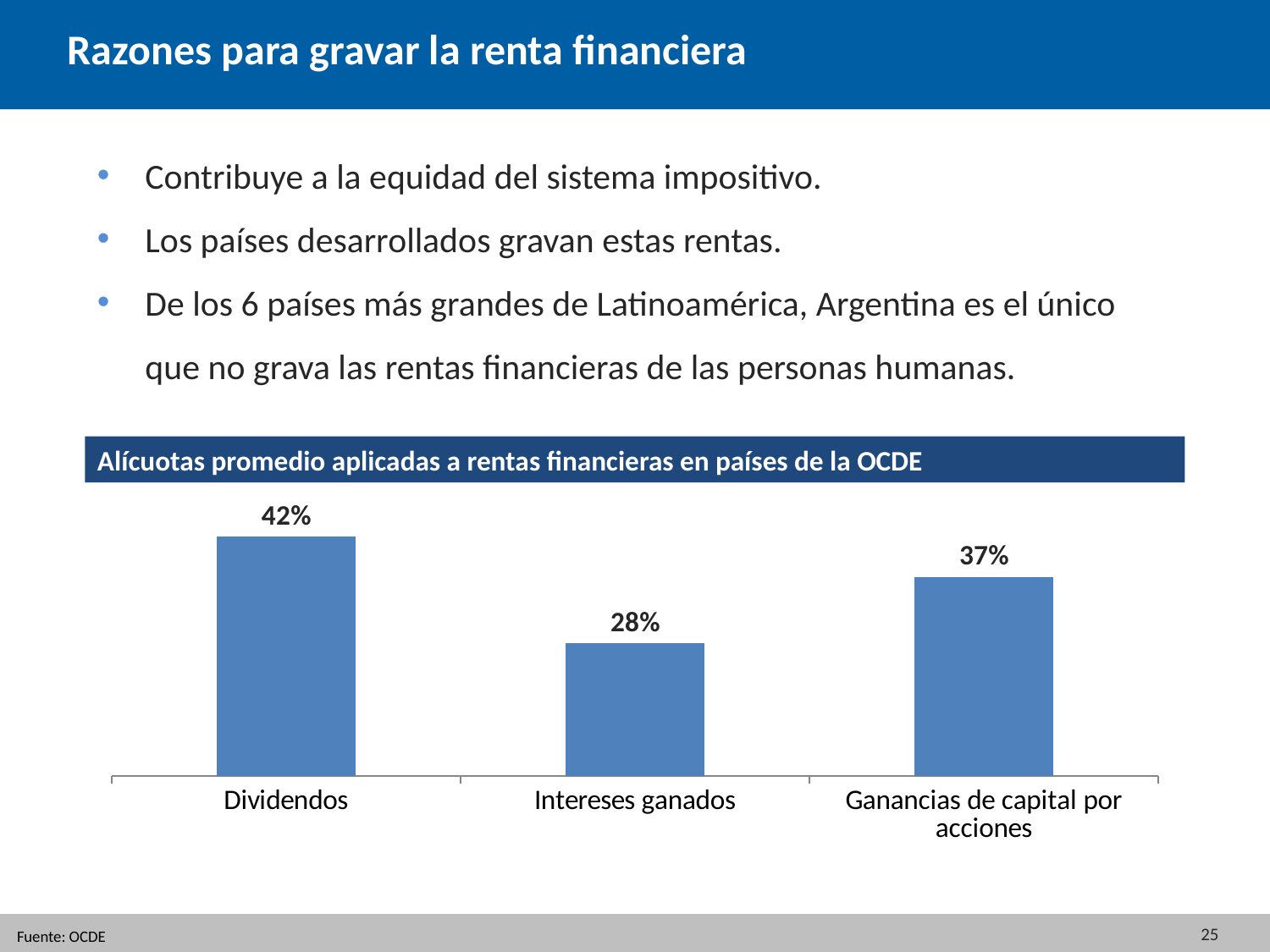
What is the average rate applied to Dividendos? 42% What is the average rate applied to Ganancias de capital por acciones? 37% Which is larger, the rate for Ganancias de capital por acciones or the rate for Intereses ganados? Ganancias de capital por acciones What is the average rate applied to Intereses ganados? 28% What kind of chart is shown on the slide? Bar chart What is the difference between the rate for Dividendos and the rate for Ganancias de capital por acciones? 5% How many categories are shown in the chart? 3 What is the source cited for the chart? OCDE What is the title of the chart? Alícuotas promedio aplicadas a rentas financieras en países de la OCDE Which category has the lowest average rate? Intereses ganados Which category has the highest average rate? Dividendos What is the difference between the rate for Dividendos and the rate for Intereses ganados? 14%